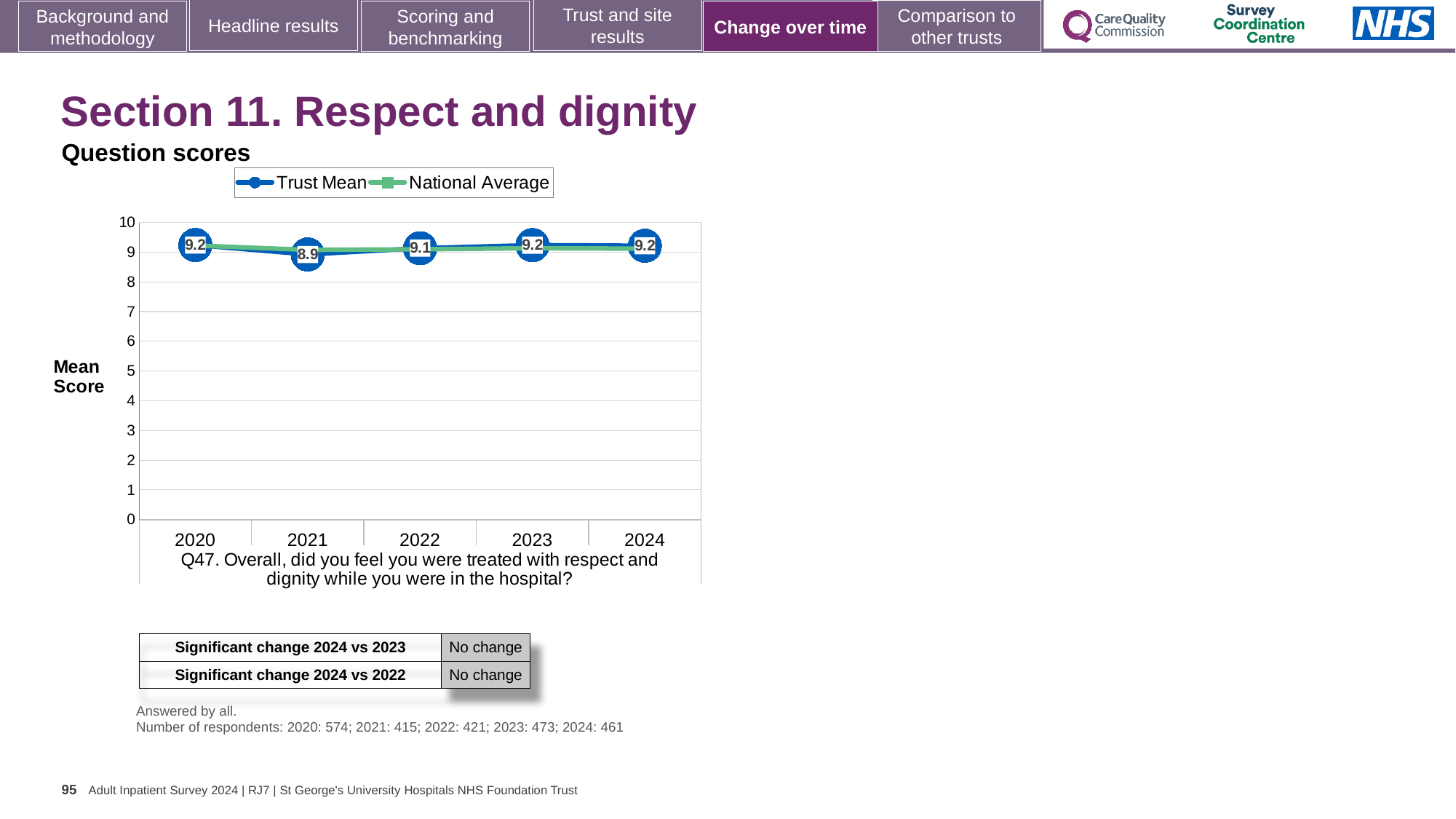
What are the two series named in the legend? Trust Mean and National Average Does the Trust Mean score rise or fall from 2021 to 2023? rise What is the Trust Mean score for 2022? 9.1 How many series does the legend list? 2 How many years are plotted on the x axis? 5 What kind of chart is shown on the slide? line chart Is the National Average value for 2021 greater or less than 8? greater In which year is the Trust Mean score lowest? 2021 What is the difference between the Trust Mean scores for 2020 and 2021? 0.3 What is the Trust Mean score for 2024? 9.2 What is the Trust Mean score for 2021? 8.9 Which year has the larger Trust Mean score, 2021 or 2022? 2022